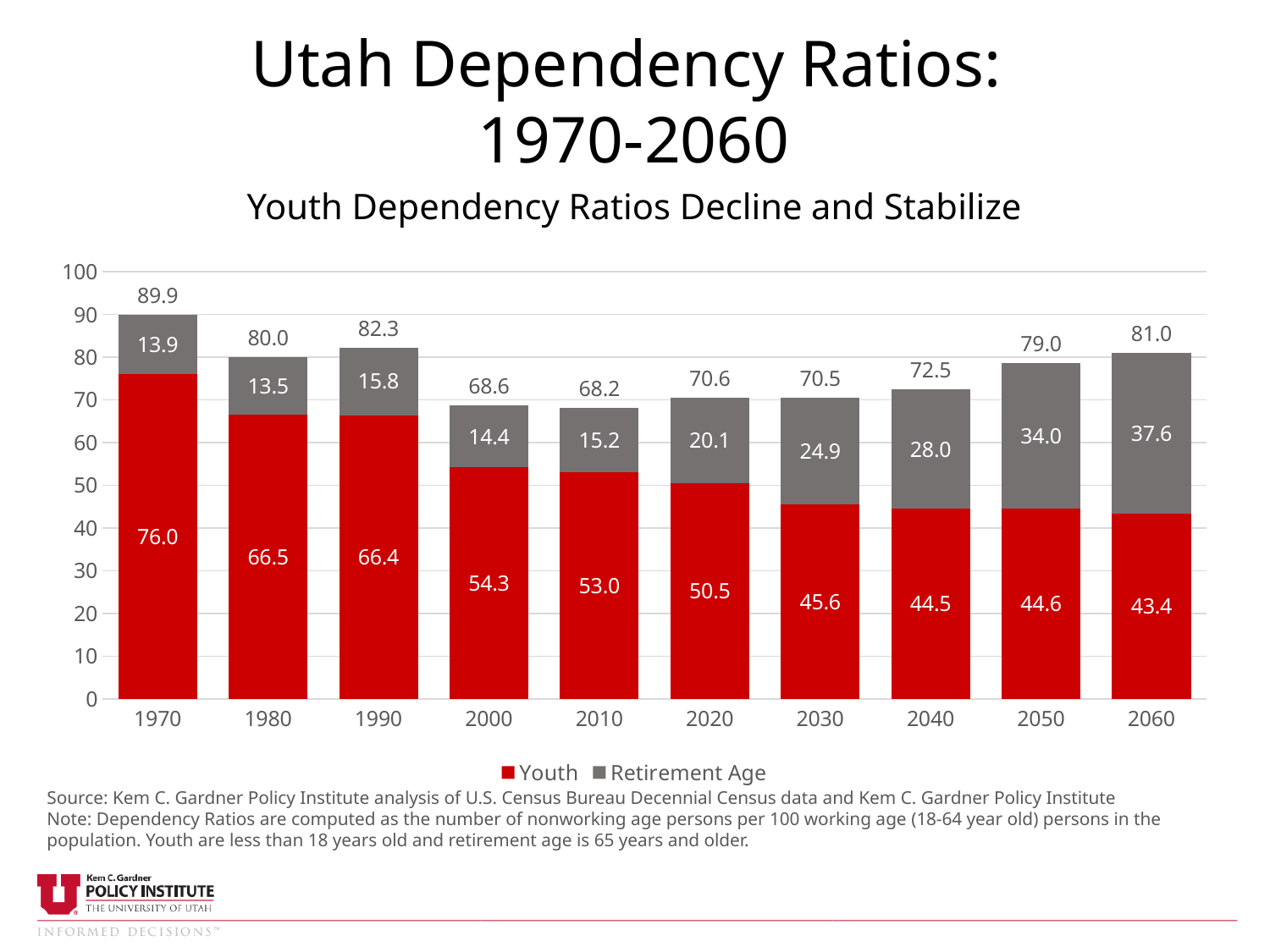
Which year has the lowest Retirement Age dependency ratio? 1980 What is the difference between the Youth dependency ratio in 1970 and in 2060? 32.6 What is the Youth dependency ratio for 1970? 76.0 Which year has the highest Youth dependency ratio? 1970 What is the Retirement Age dependency ratio for 2060? 37.6 How many years are shown on the x axis? 10 What kind of chart is shown on the slide? Stacked bar chart Which year has the lowest total dependency ratio? 2010 Is the Retirement Age dependency ratio larger in 2050 or in 2040? 2050 What is the total dependency ratio shown above the bar for 2000? 68.6 How many series does the legend list? 2 Does the Retirement Age dependency ratio rise or fall from 2000 to 2060? Rise